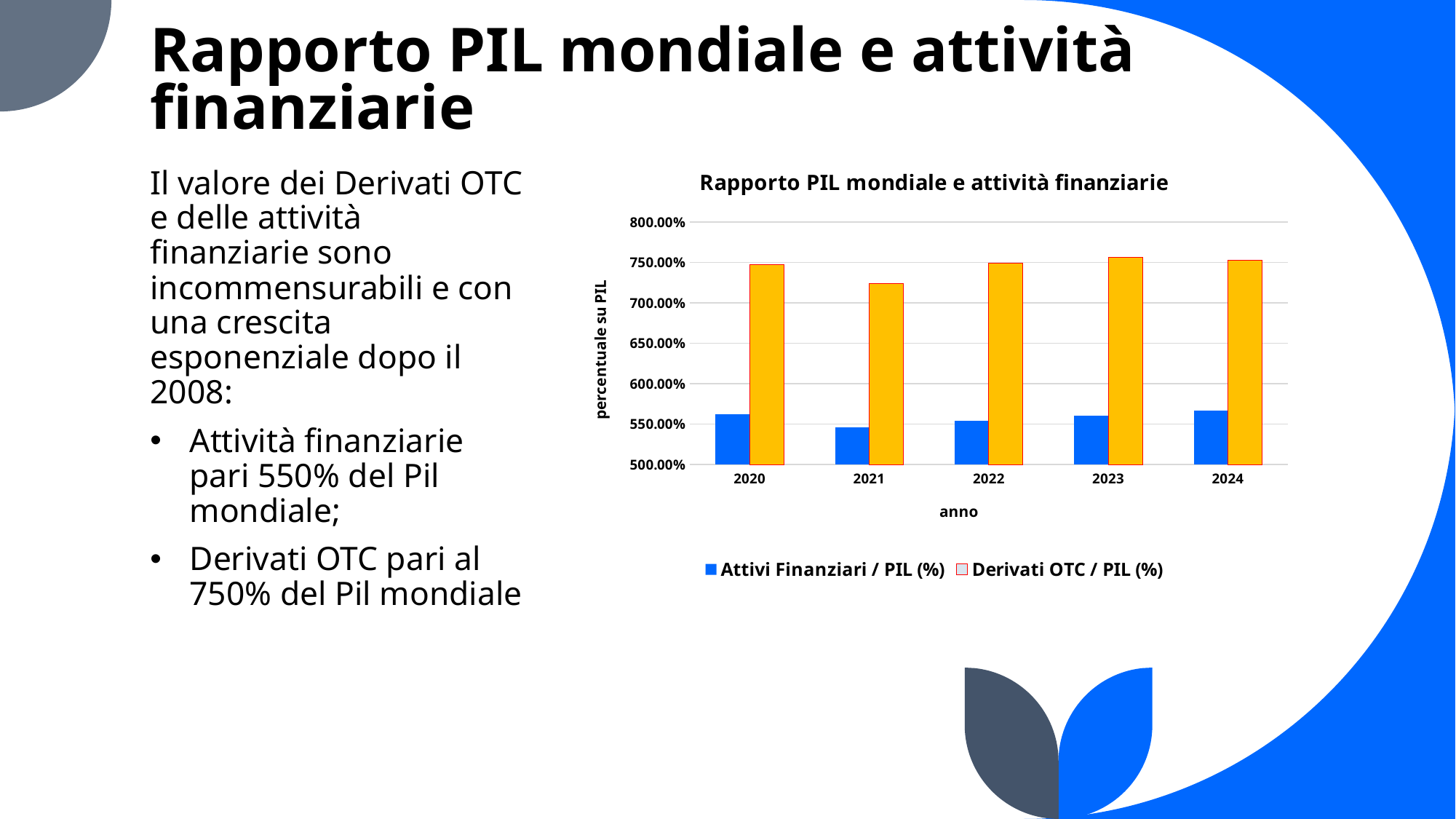
How many years are shown on the x axis of the chart? 5 Is the Derivati OTC / PIL (%) value for 2021 greater or less than 700.00%? greater How many series does the chart legend list? 2 Is the Attivi Finanziari / PIL (%) value for 2024 greater or less than 550.00%? greater For Derivati OTC / PIL (%), which year has the larger value: 2021 or 2022? 2022 In which year is the Derivati OTC / PIL (%) value lowest? 2021 What is the label of the vertical axis of the chart? percentuale su PIL What is the title of the chart? Rapporto PIL mondiale e attività finanziarie In 2022, which series has the larger value: Attivi Finanziari / PIL (%) or Derivati OTC / PIL (%)? Derivati OTC / PIL (%) What kind of chart is shown on the slide? bar chart In which year is the Attivi Finanziari / PIL (%) value lowest? 2021 Is the Derivati OTC / PIL (%) value for 2021 greater or less than 750.00%? less